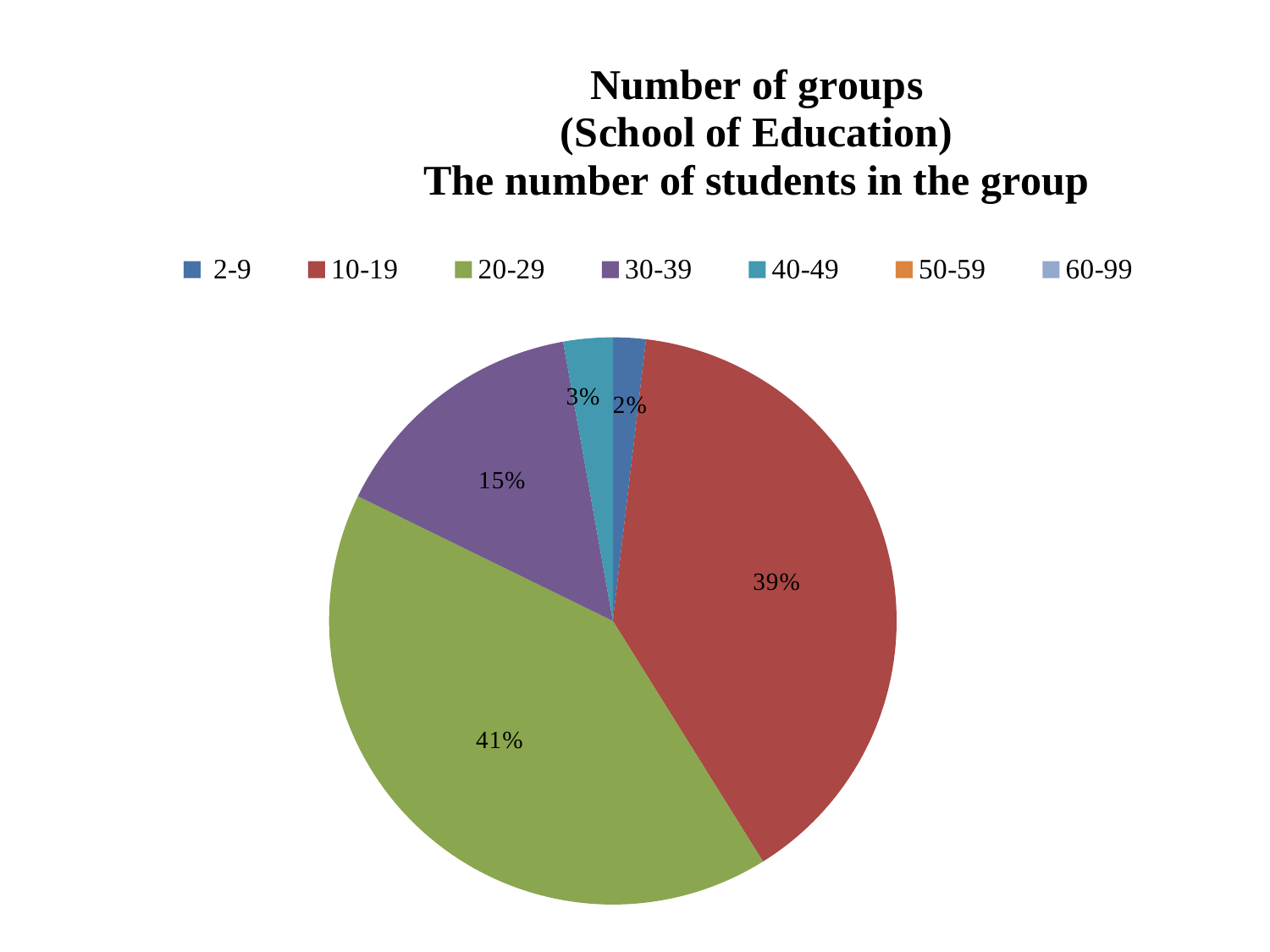
What share of the pie does the 40-49 slice represent? 3% Which slice is larger, 30-39 or 40-49? 30-39 Which of the labelled slices has the smallest share of the pie? 2-9 How many categories does the legend list? 7 Which group size category has the largest share of the pie? 20-29 What kind of chart is shown on the slide? pie chart What share of the pie does the 10-19 slice represent? 39% What is the difference in percentage points between the 20-29 slice and the 10-19 slice? 2 What share of the pie does the 20-29 slice represent? 41% What colour is the 10-19 slice? red